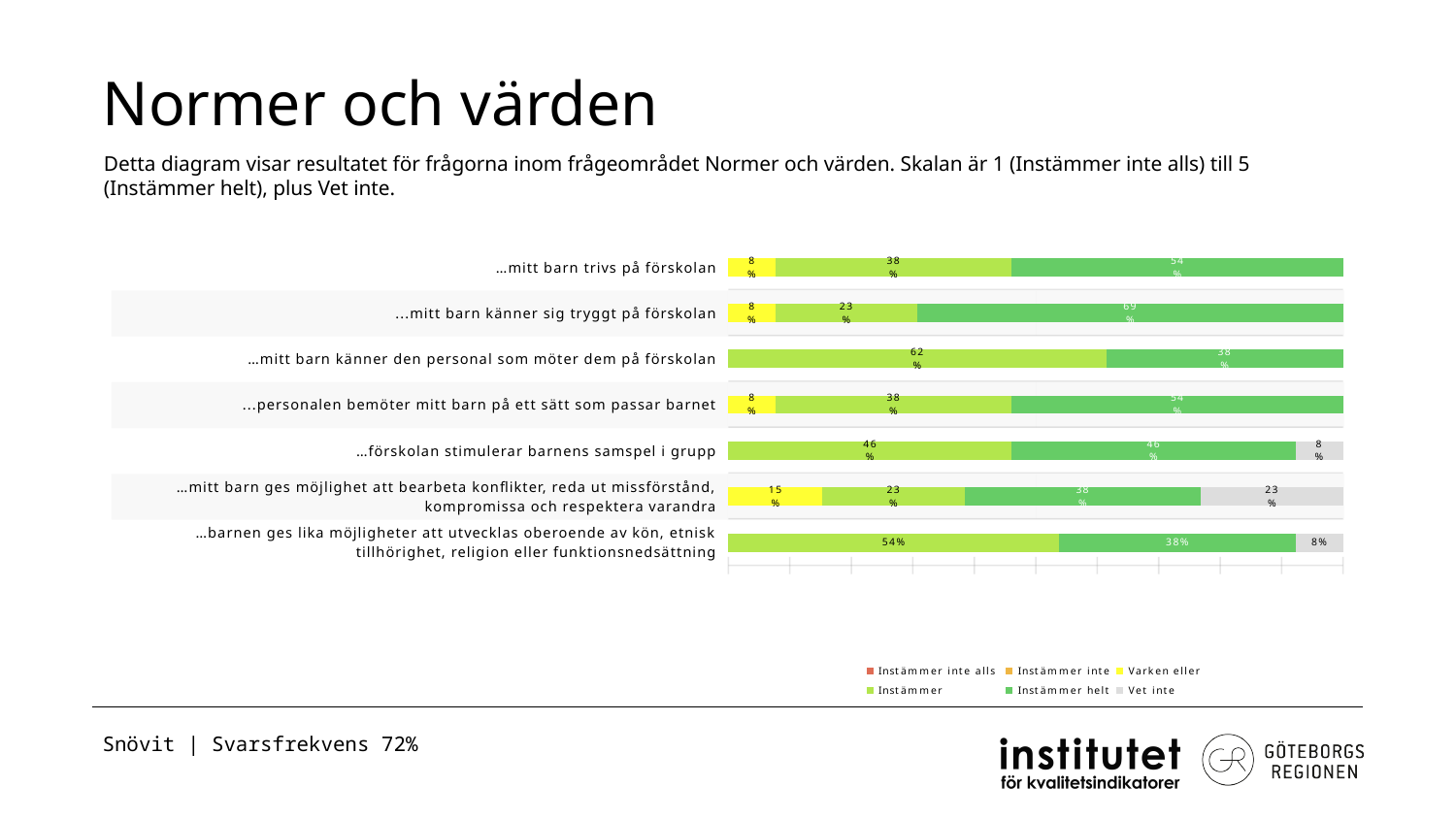
What is the "Vet inte" share for "…mitt barn ges möjlighet att bearbeta konflikter, reda ut missförstånd, kompromissa och respektera varandra"? 23% What is the combined share of "Instämmer" and "Instämmer helt" for "…förskolan stimulerar barnens samspel i grupp"? 92% Which statement has the highest "Instämmer helt" percentage? …mitt barn känner sig tryggt på förskolan Which statement has the largest "Varken eller" share? …mitt barn ges möjlighet att bearbeta konflikter, reda ut missförstånd, kompromissa och respektera varandra What is the difference between the "Instämmer helt" percentages for "…mitt barn känner sig tryggt på förskolan" and "…mitt barn trivs på förskolan"? 15 percentage points What percentage answered "Instämmer" for "…mitt barn känner den personal som möter dem på förskolan"? 62% For "…barnen ges lika möjligheter att utvecklas oberoende av kön, etnisk tillhörighet, religion eller funktionsnedsättning", which is larger: "Instämmer" or "Instämmer helt"? Instämmer What type of chart is shown on the slide? Stacked bar chart How many statements (bars) are shown in the chart? 7 What is the response rate (Svarsfrekvens) shown at the bottom of the slide? 72% What percentage of respondents answered "Instämmer helt" for "…mitt barn känner sig tryggt på förskolan"? 69% How many response categories does the legend list? 6